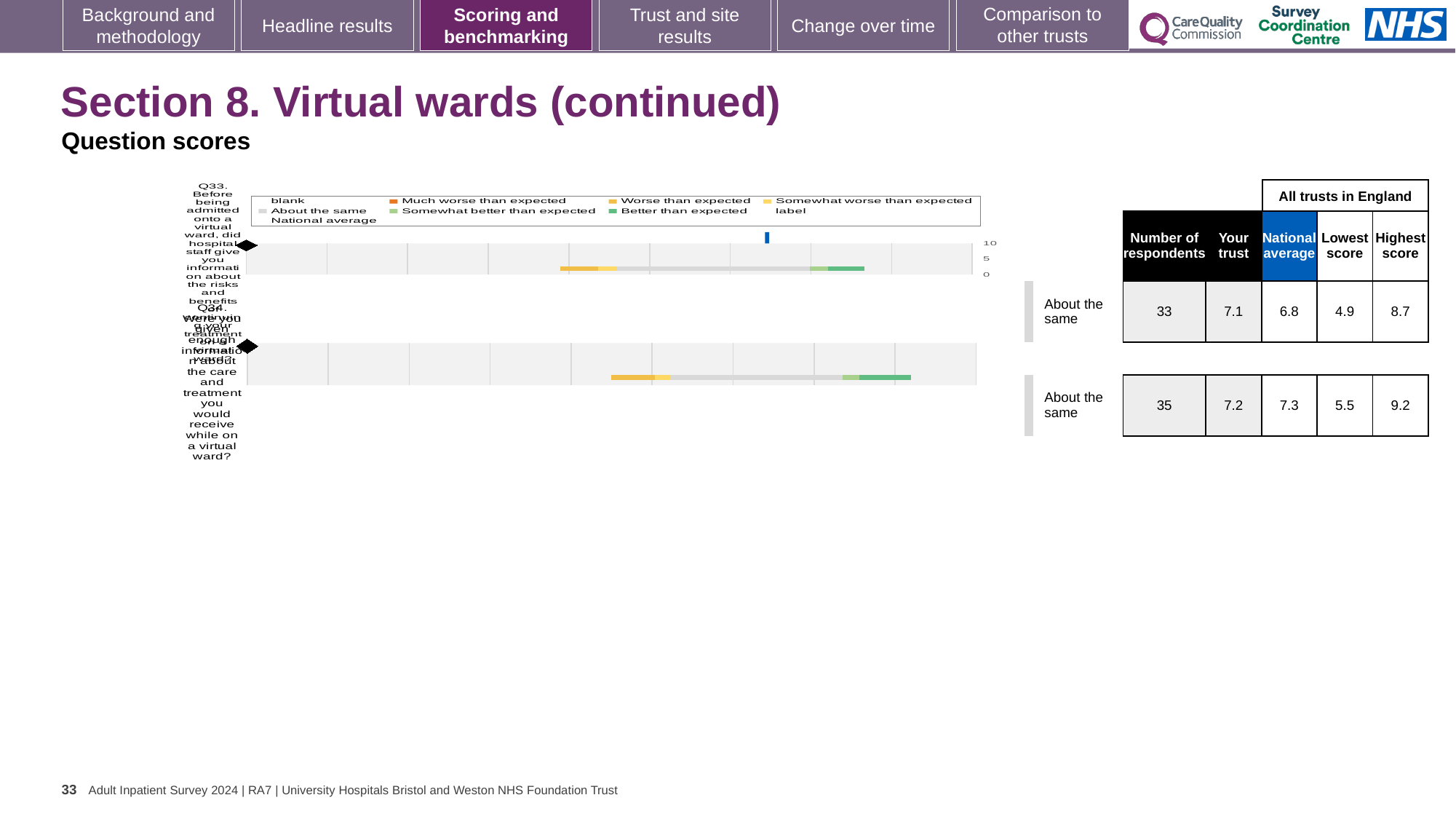
How many respondents answered Q34? 35 What kind of chart is shown on the slide? bar chart What is the highest score among all trusts in England for Q34? 9.2 Is the trust's score for Q33 greater or less than 5 on the chart's axis? greater What is the national average score for Q33? 6.8 Which is larger for Q34: the trust's score or the national average? national average How many questions (bars) are plotted in the chart? 2 What is the 'Your trust' score for Q34 (enough information about the care and treatment on a virtual ward)? 7.2 What is the 'Your trust' score for Q33 (information about the risks and benefits of a virtual ward)? 7.1 Which legend entry is shown in dark green? Better than expected What is the difference between the highest and lowest scores for Q33 across all trusts in England? 3.8 What benchmark category is the trust placed in for Q33? About the same